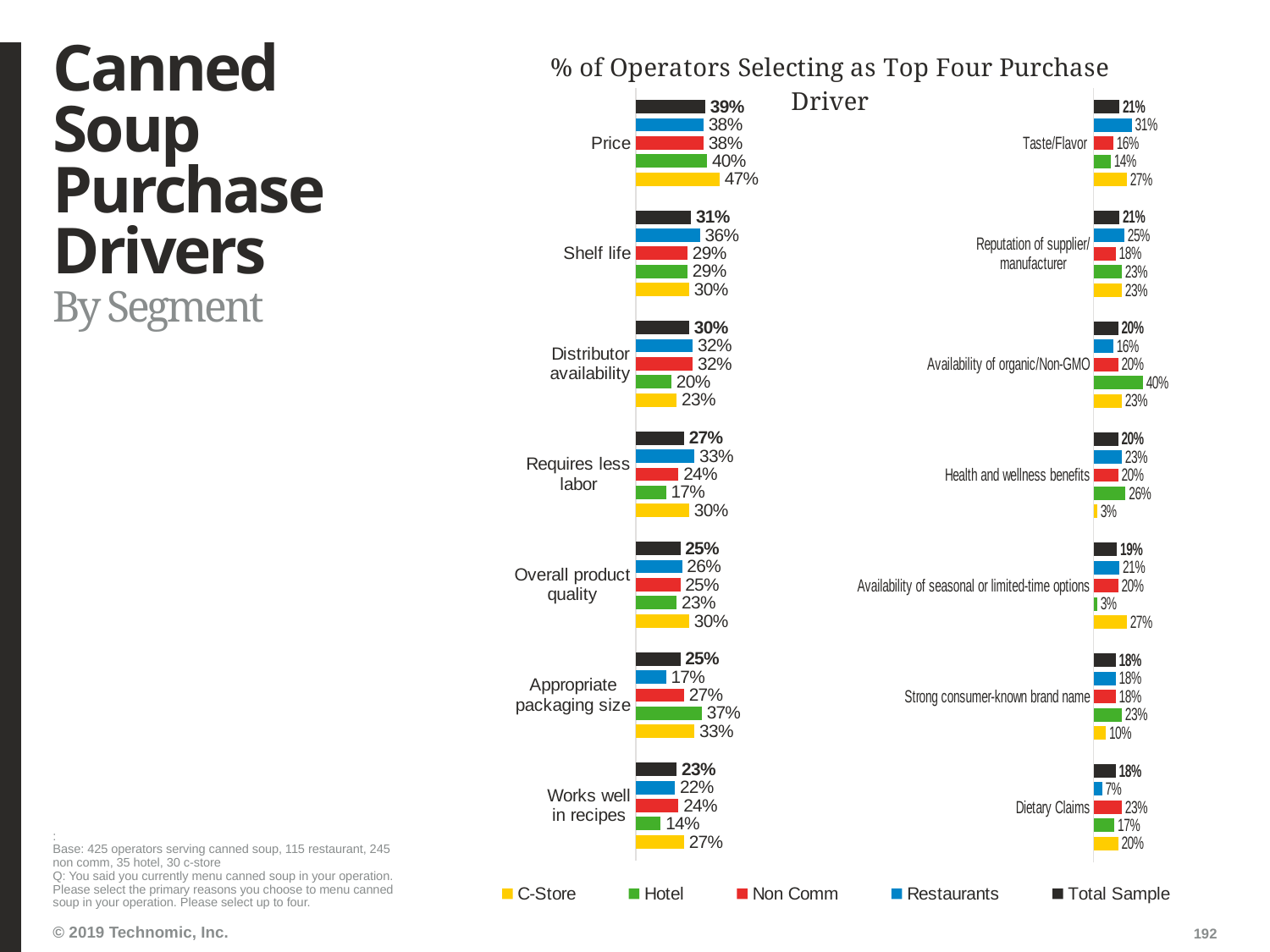
In the right chart, which is larger for Taste/Flavor: the Restaurants value or the Non Comm value? Restaurants In the right chart, what is the Hotel value for Availability of organic/Non-GMO? 40% How many purchase drivers are shown in the left chart? 7 In the left chart, what is the Total Sample value for Shelf life? 31% How many segments does the legend list? 5 In the left chart, what percentage of C-Store operators selected Price as a top four purchase driver? 47% What type of chart is used on this slide? Bar chart In the left chart, which purchase driver has the highest Total Sample value? Price In the right chart, which segment has the lowest value for Health and wellness benefits? C-Store In the right chart, what is the Restaurants value for Dietary Claims? 7% In the left chart, what is the difference between the Hotel and Restaurants values for Appropriate packaging size? 20% Which colour represents the Non Comm segment in the legend? Red